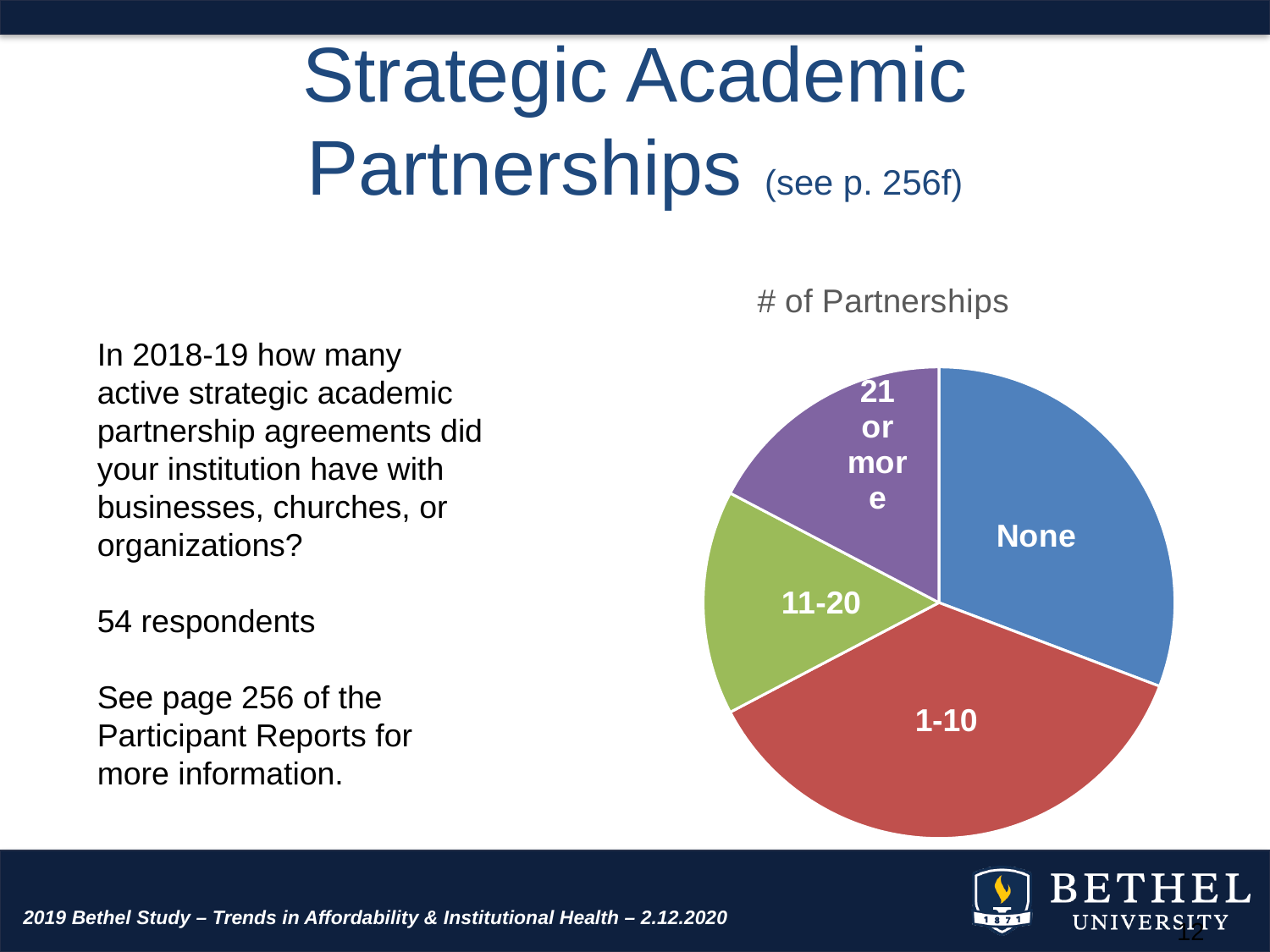
What kind of chart is shown on the slide? pie chart Which category has the largest slice in the pie chart? 1-10 Which slice is larger, None or 21 or more? None What colour is the slice labelled None? blue Which slice is larger, None or 11-20? None Which slice is larger, 1-10 or 11-20? 1-10 What is the title of the pie chart? # of Partnerships How many slices does the pie chart have? 4